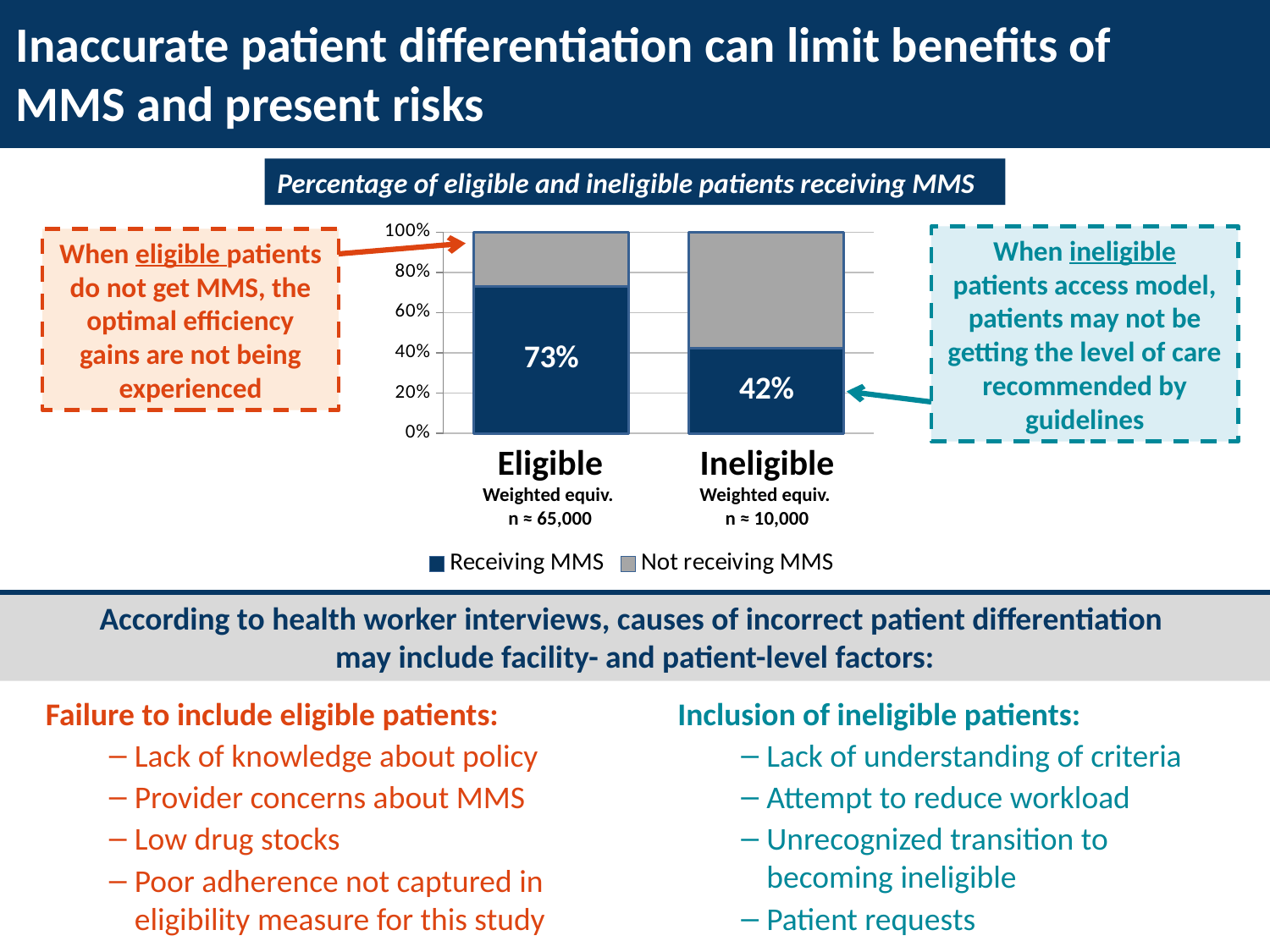
What type of chart is shown on the slide? Stacked bar chart How many categories are shown on the x axis of the chart? 2 How many series does the chart legend list? 2 What percentage of eligible patients are receiving MMS? 73% Is the share of eligible patients receiving MMS greater or less than 60%? greater Is the share of ineligible patients receiving MMS greater or less than 60%? less What is the title of the chart? Percentage of eligible and ineligible patients receiving MMS What percentage of ineligible patients are receiving MMS? 42% What is the difference in percentage points between eligible and ineligible patients receiving MMS? 31 percentage points Which series is shown in grey in the chart? Not receiving MMS Which category has the lowest percentage of patients receiving MMS? Ineligible Which category has the higher share of patients receiving MMS, Eligible or Ineligible? Eligible